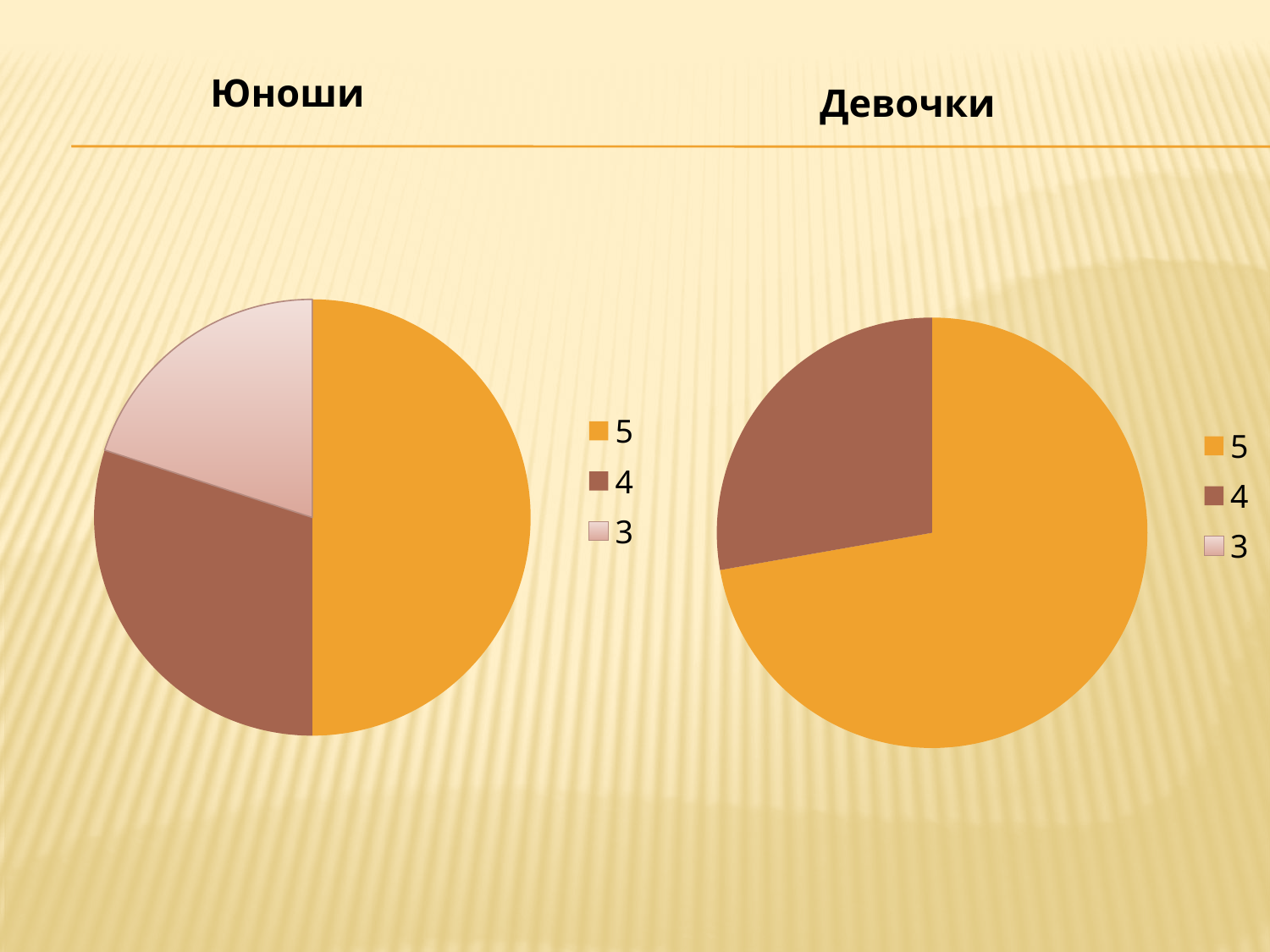
In the "Юноши" chart, how many entries does the legend list? 3 In the "Юноши" chart, which slice is larger, 4 or 3? 4 In the "Юноши" chart, which category has the largest slice? 5 In the "Девочки" chart, how many slices are visible in the pie? 2 In the "Девочки" chart, which category has the largest slice? 5 How many charts are on the slide? 2 In the "Юноши" chart, which category has the smallest slice? 3 What are the titles of the two charts on the slide, left to right? Юноши, Девочки What kind of chart is shown under the title "Юноши"? pie chart In the "Девочки" chart, which slice is larger, 5 or 4? 5 In the "Девочки" chart, how many entries does the legend list? 3 What kind of chart is shown under the title "Девочки"? pie chart